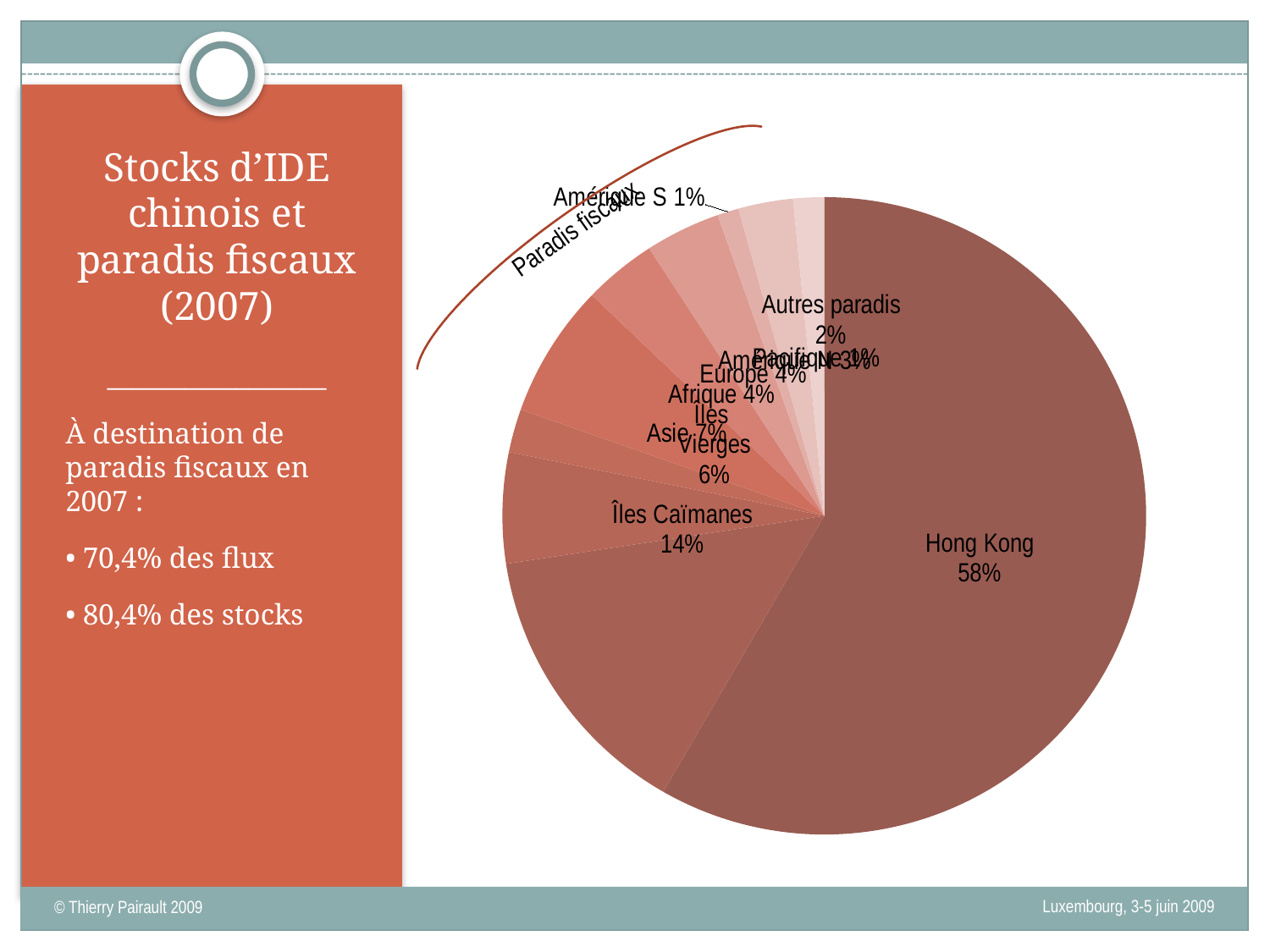
What is the value shown for Asie? 7% What is the value shown for Afrique? 4% Which is larger, the slice for Asie or the slice for Îles Vierges? Asie What is the value shown for Îles Caïmanes? 14% What kind of chart is shown on the slide? Pie chart What is the difference in percentage points between Hong Kong and Îles Caïmanes? 44 What share of the pie does Hong Kong represent? 58% What is the value shown for Europe? 4% What is the value shown for Autres paradis? 2% What is the value shown for Îles Vierges? 6% Which category has the largest slice of the pie? Hong Kong What is the value shown for Amérique S? 1%